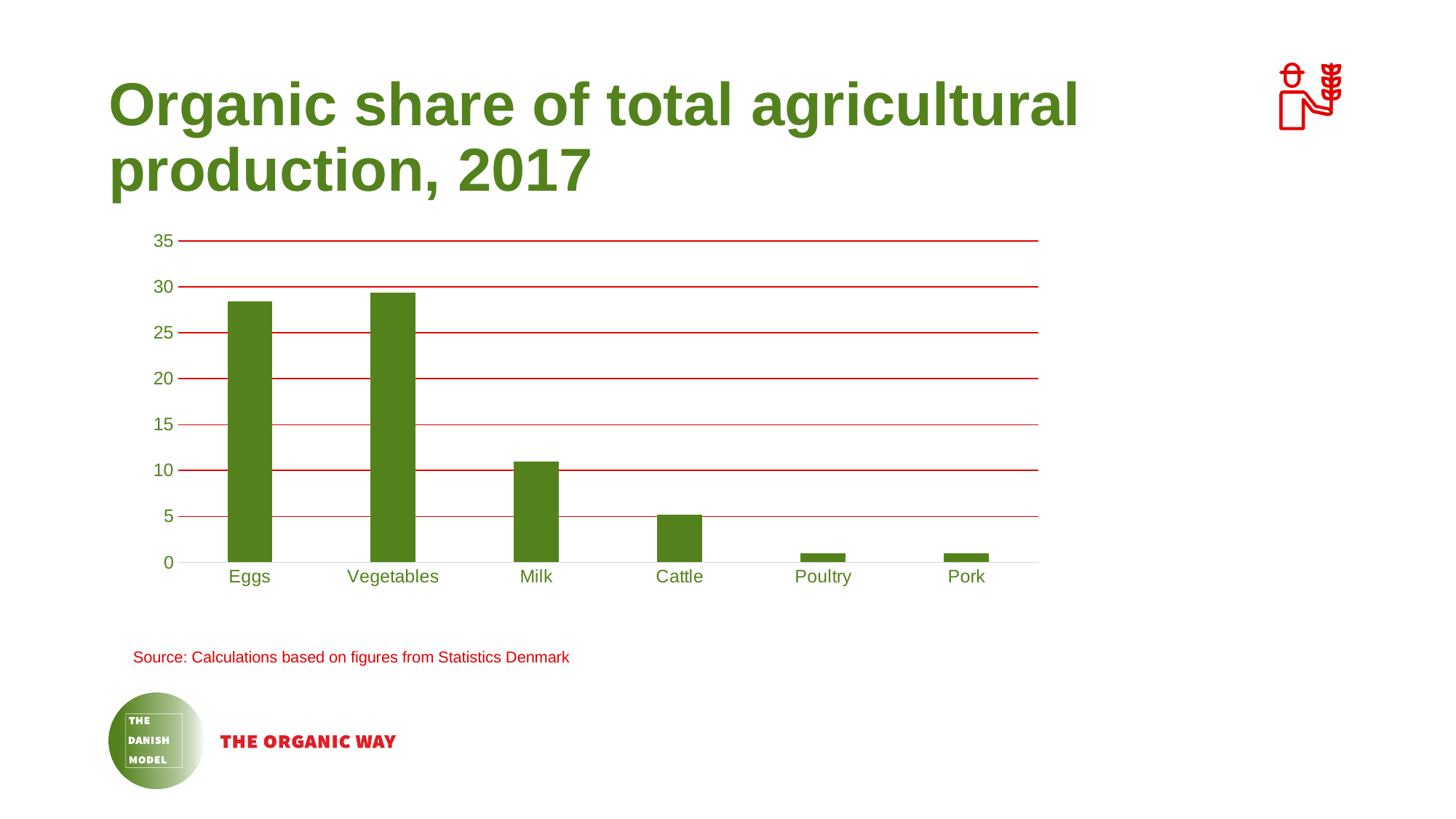
Do the values generally rise or fall moving from left to right along the x axis? fall Is the value for Eggs greater or less than 25? greater What kind of chart is shown on the slide? bar chart Is the value for Poultry greater or less than 5? less Is the value for Cattle greater or less than 10? less Which has a larger value, Cattle or Vegetables? Vegetables Which has a larger value, Eggs or Milk? Eggs How many categories are shown on the x axis of the chart? 6 What is the title of the chart on the slide? Organic share of total agricultural production, 2017